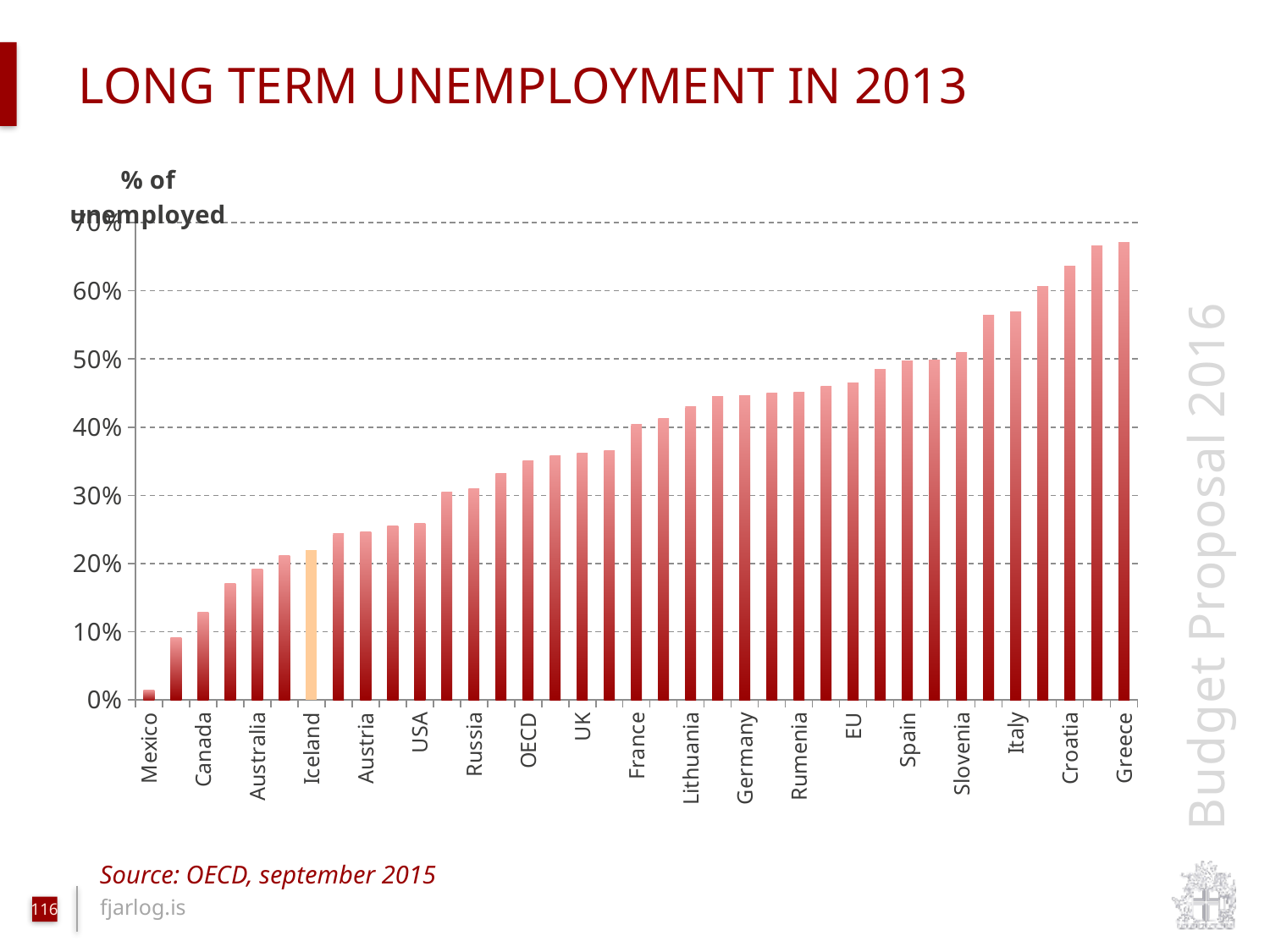
Is the value for USA greater or less than 30%? less Is the value for UK greater or less than 40%? less Do the values rise or fall from left to right along the x axis? rise Which country has the lowest long-term unemployment share in the chart? Mexico Is the value for Mexico greater or less than 10%? less Which country's bar is highlighted in a different colour (orange) from the rest? Iceland Which country has the highest long-term unemployment share in the chart? Greece Which has a higher value, Canada or Italy? Italy What kind of chart is shown on the slide? bar chart